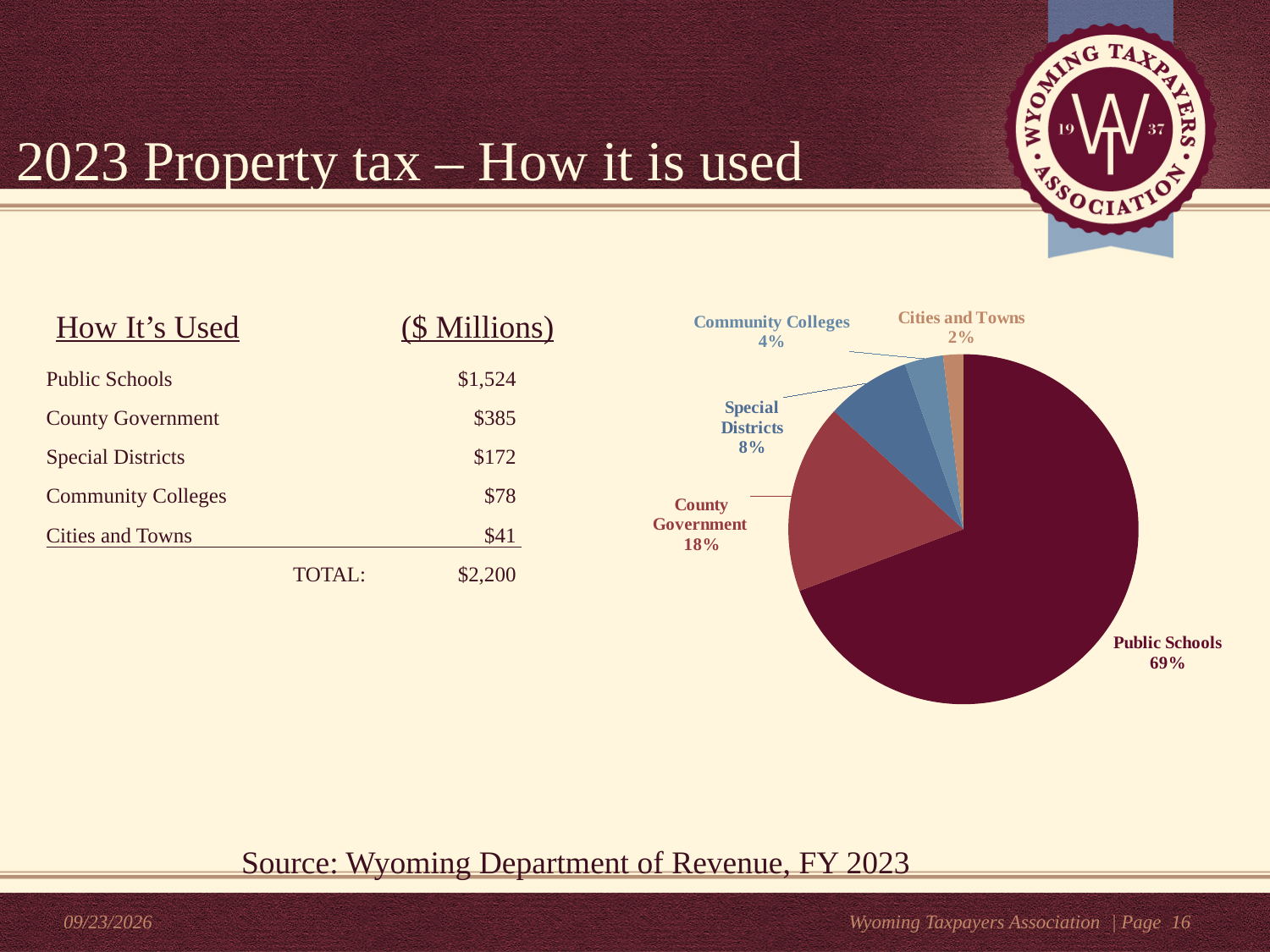
Is the Public Schools slice greater or less than 50% of the pie? greater What is the difference in percentage points between the Public Schools slice and the County Government slice? 51 What share of the pie does County Government represent? 18% Which category has the smallest slice of the pie? Cities and Towns Which slice is larger, County Government or Special Districts? County Government Which category has the largest slice of the pie? Public Schools What share of the pie does Special Districts represent? 8% How many slices does the pie chart have? 5 What share of the pie does Community Colleges represent? 4% What kind of chart is shown on the slide? pie chart